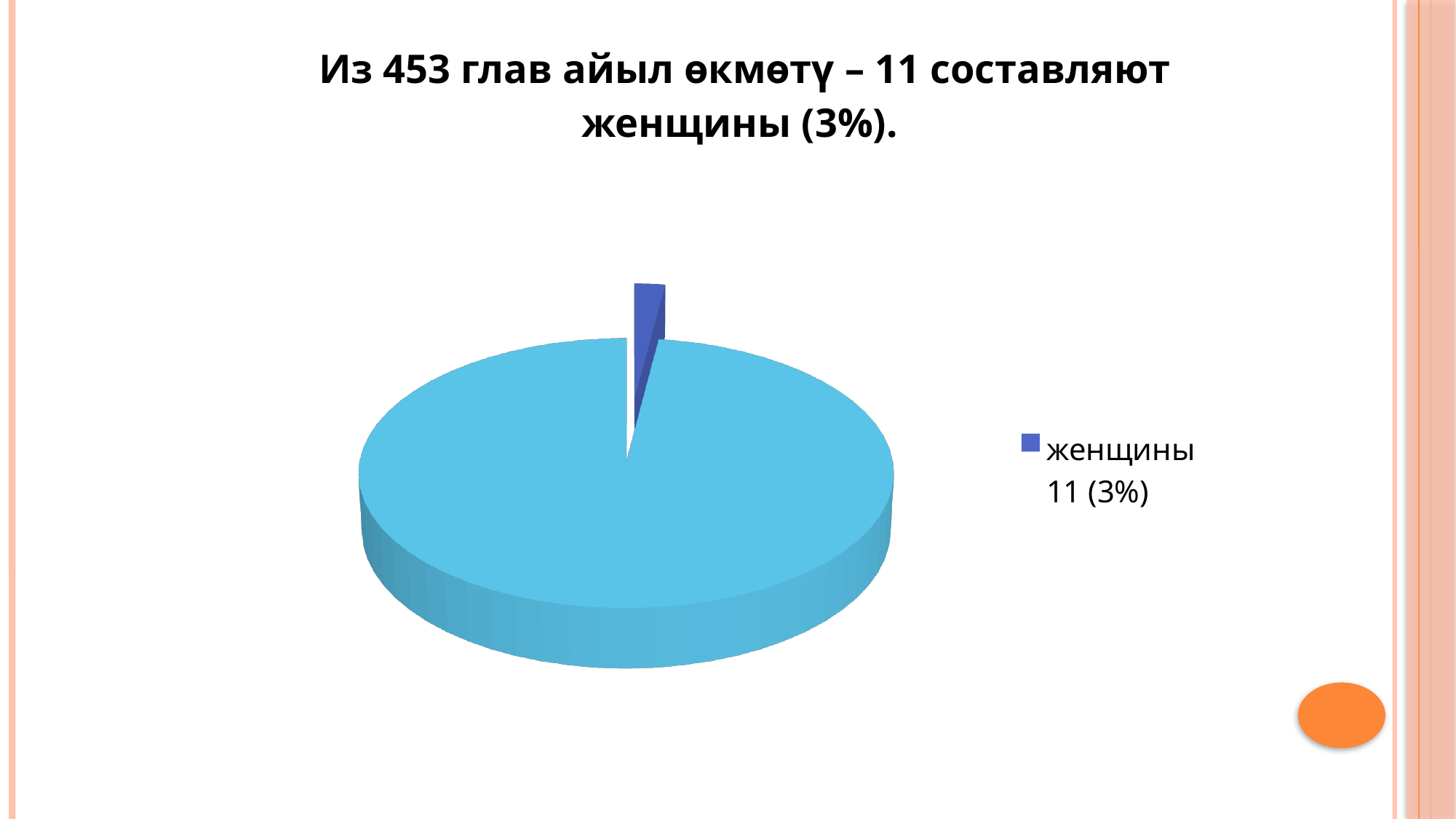
How many slices does the pie chart have? 2 What share of the pie does the женщины slice represent? 3% What colour is the женщины slice in the pie chart? dark blue What is the value shown for женщины in the legend? 11 (3%) According to the slide title, how many heads of айыл өкмөтү are there in total? 453 Is the женщины slice larger or smaller than the other slice of the pie? smaller Is the женщины slice the smallest slice of the pie? yes What is the title of the slide? Из 453 глав айыл өкмөтү – 11 составляют женщины (3%). What kind of chart is shown on the slide? pie chart How many entries does the legend list? 1